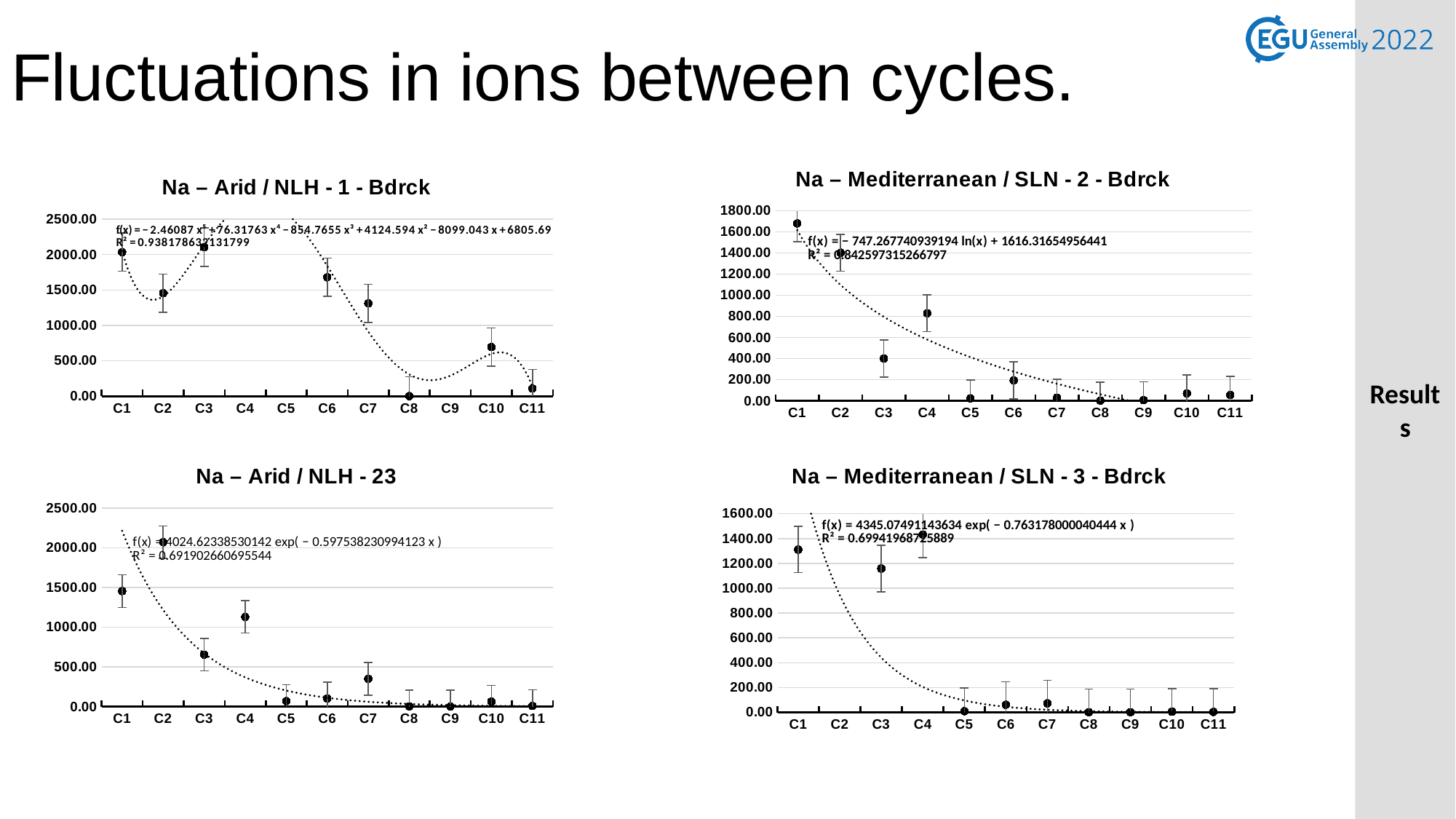
In the chart titled "Na – Mediterranean / SLN - 3 - Bdrck", which is larger, the value for C1 or the value for C3? C1 How many charts are shown on the slide? 4 In the chart titled "Na – Arid / NLH - 23", is the value for C4 greater or less than 1000? greater In the chart titled "Na – Arid / NLH - 23", which cycle has the highest value? C2 How many cycle categories are shown on the x axis of the chart titled "Na – Arid / NLH - 23"? 11 Do the values in the chart titled "Na – Mediterranean / SLN - 3 - Bdrck" generally rise or fall from C1 to C11? fall In the chart titled "Na – Arid / NLH - 1 - Bdrck", is the value for C7 greater or less than 1000? greater In the chart titled "Na – Mediterranean / SLN - 2 - Bdrck", is the value for C3 greater or less than 600? less In the chart titled "Na – Mediterranean / SLN - 2 - Bdrck", which cycle has the highest value? C1 In the chart titled "Na – Mediterranean / SLN - 2 - Bdrck", which is larger, the value for C4 or the value for C3? C4